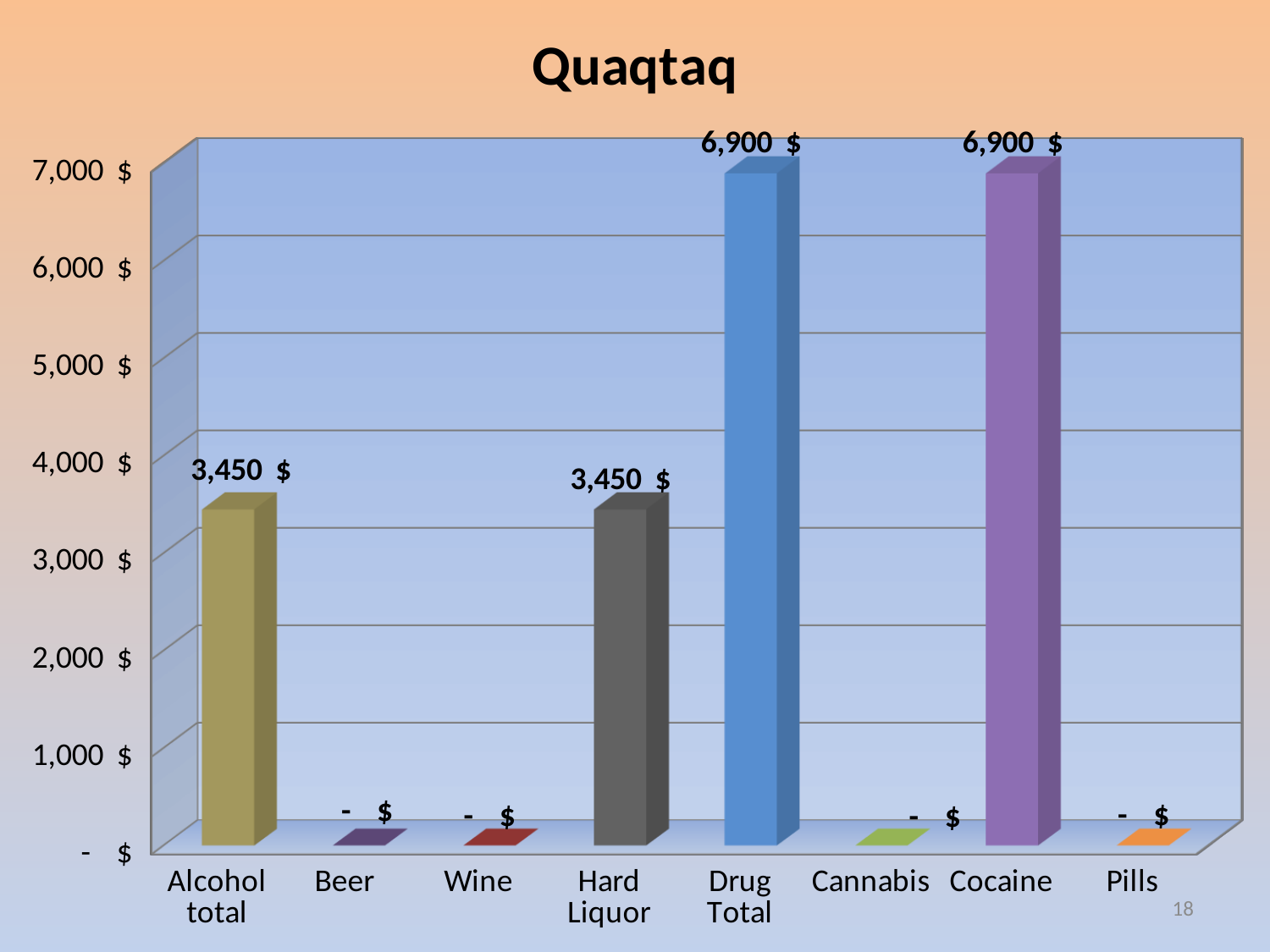
What kind of chart is shown on the slide? Bar chart What is the value for Drug Total? 6,900 $ What is the difference between the Drug Total and the Alcohol total? 3,450 $ Which is larger, the value for Cocaine or the value for Hard Liquor? Cocaine Is the value for Hard Liquor greater or less than 3,000 $? greater What is the value for Alcohol total? 3,450 $ What is the title of the chart? Quaqtaq How many categories are shown on the x axis? 8 What is the value shown for Beer? - $ What is the value for Cocaine? 6,900 $ What is the value for Hard Liquor? 3,450 $ What is the highest value shown on the vertical axis? 7,000 $